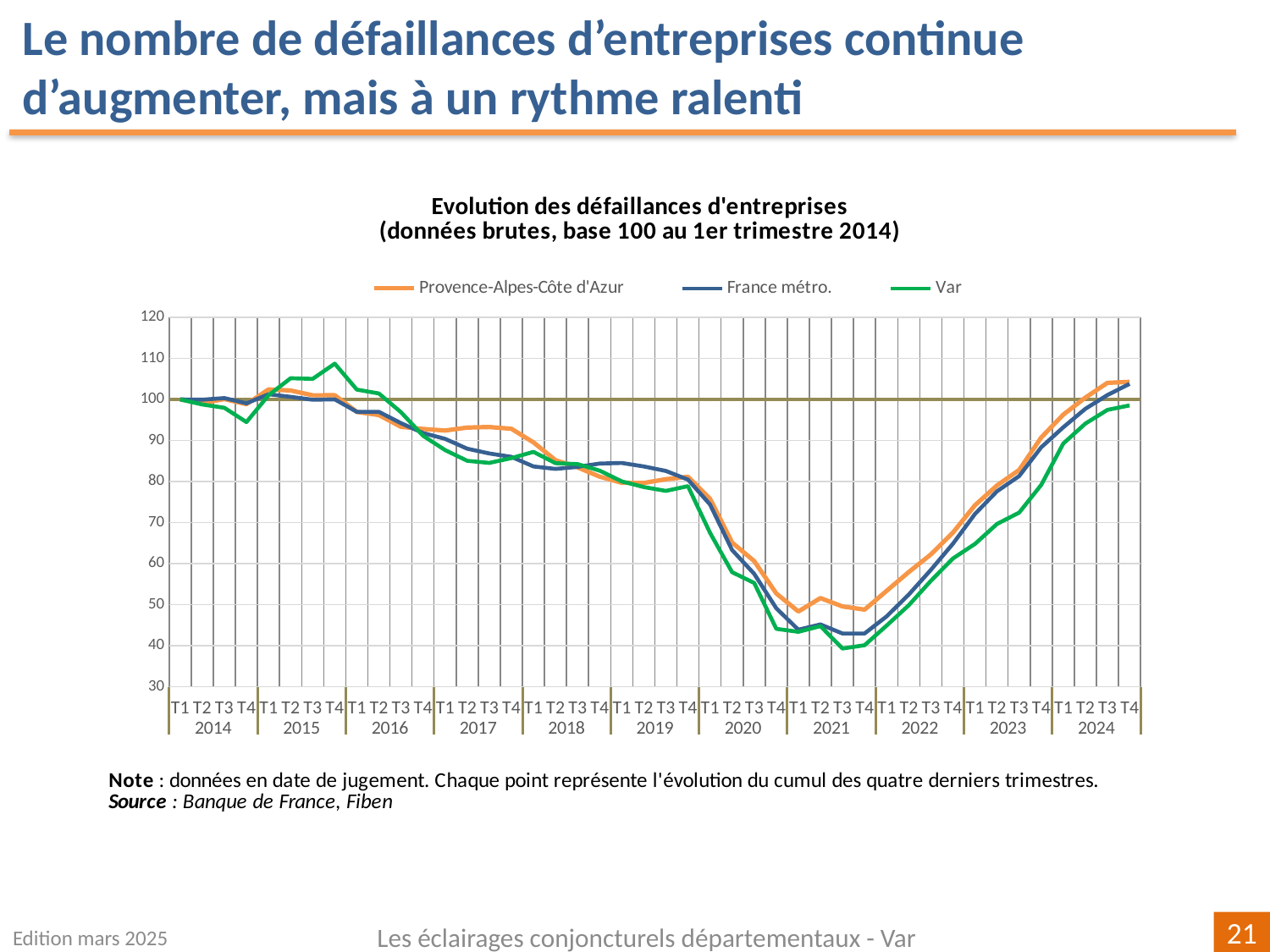
Is the value for Provence-Alpes-Côte d'Azur at T4 2024 greater or less than 100? greater Which series has the highest value at T4 2015? Var Is the value for Var at T3 2020 greater or less than 60? less What is the base value and period stated in the chart title? base 100 au 1er trimestre 2014 Is the value for Var at T4 2015 greater or less than 100? greater What kind of chart is shown on the slide? line chart Do the values for France métro. rise or fall from T1 2022 to T4 2024? rise Which series is drawn in green? Var Which series has the lowest value at T4 2021? Var How many series does the legend list? 3 How many years are labelled along the x axis? 11